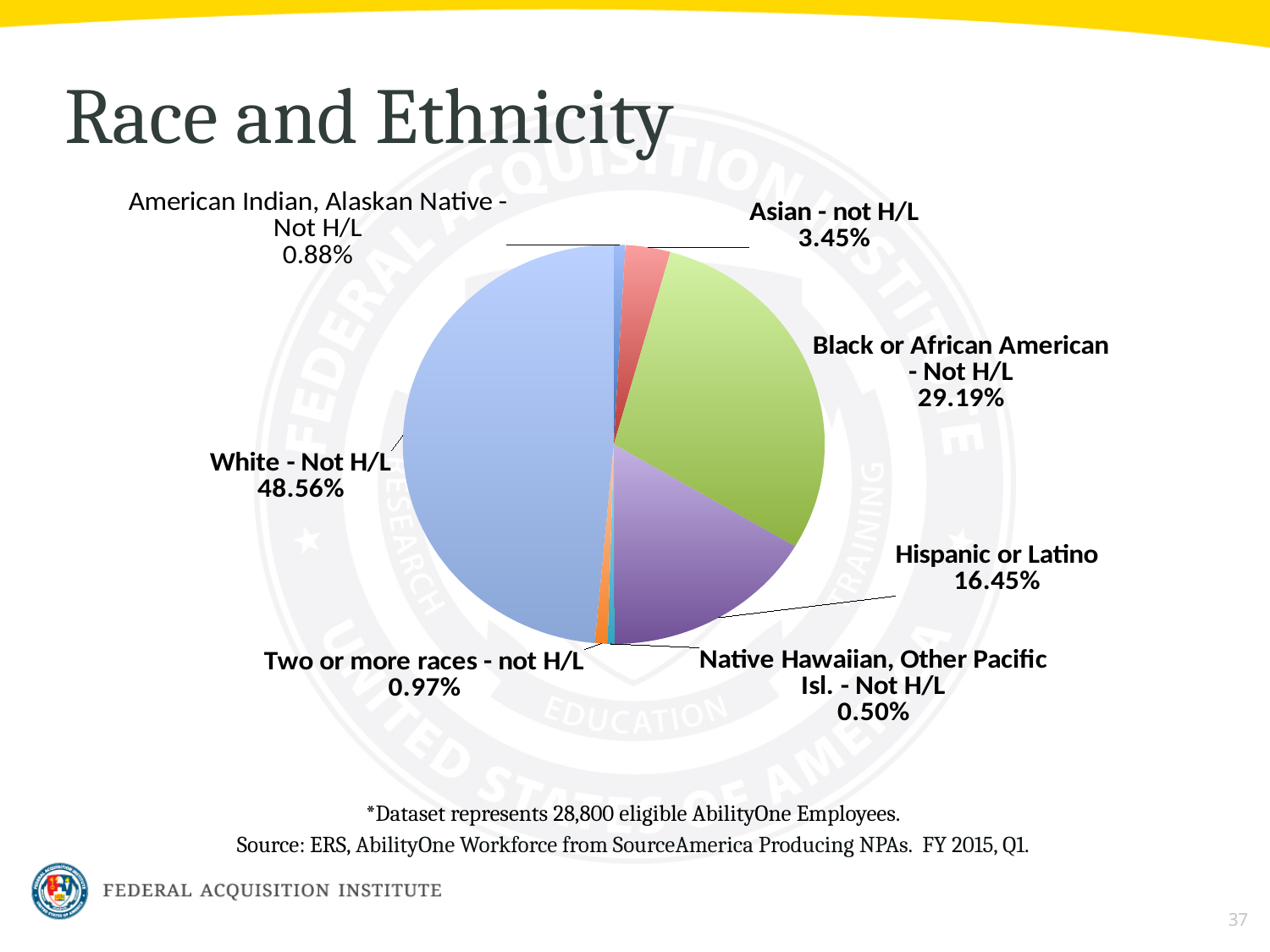
What percentage is shown for White - Not H/L? 48.56% Which is larger, the share for Hispanic or Latino or the share for Asian - not H/L? Hispanic or Latino Which category has the smallest share of the pie? Native Hawaiian, Other Pacific Isl. - Not H/L What is the title of the chart on the slide? Race and Ethnicity What is the difference in percentage points between White - Not H/L and Black or African American - Not H/L? 19.37 What percentage is shown for Asian - not H/L? 3.45% Which category has the largest share of the pie? White - Not H/L What percentage is shown for Black or African American - Not H/L? 29.19% How many slices does the pie chart have? 7 What kind of chart is shown on the slide? Pie chart What percentage is shown for Native Hawaiian, Other Pacific Isl. - Not H/L? 0.50% What percentage is shown for Hispanic or Latino? 16.45%